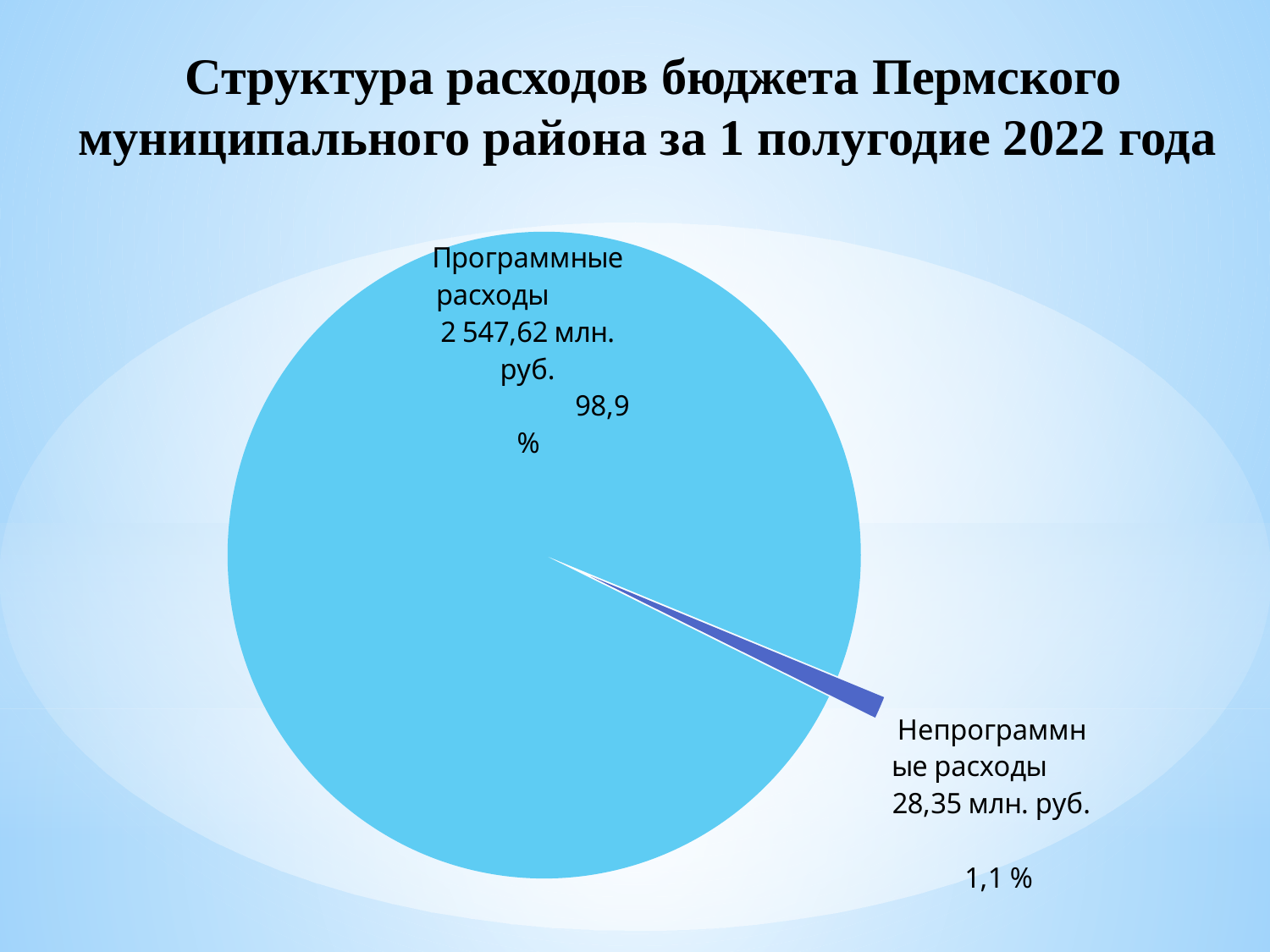
What is the difference between Программные расходы and Непрограммные расходы? 2 519,27 млн. руб. What is the value for Программные расходы? 2 547,62 млн. руб. What is the value for Непрограммные расходы? 28,35 млн. руб. How many slices does the pie chart have? 2 What kind of chart is shown on the slide? Pie chart What share of the pie does Программные расходы take? 98,9 % Which is larger, Программные расходы or Непрограммные расходы? Программные расходы Which category is the smallest slice of the pie? Непрограммные расходы What share of the pie does Непрограммные расходы take? 1,1 % Which category is the largest slice of the pie? Программные расходы What is the title of the slide? Структура расходов бюджета Пермского муниципального района за 1 полугодие 2022 года What is the total of the two slices in the pie? 2 575,97 млн. руб.